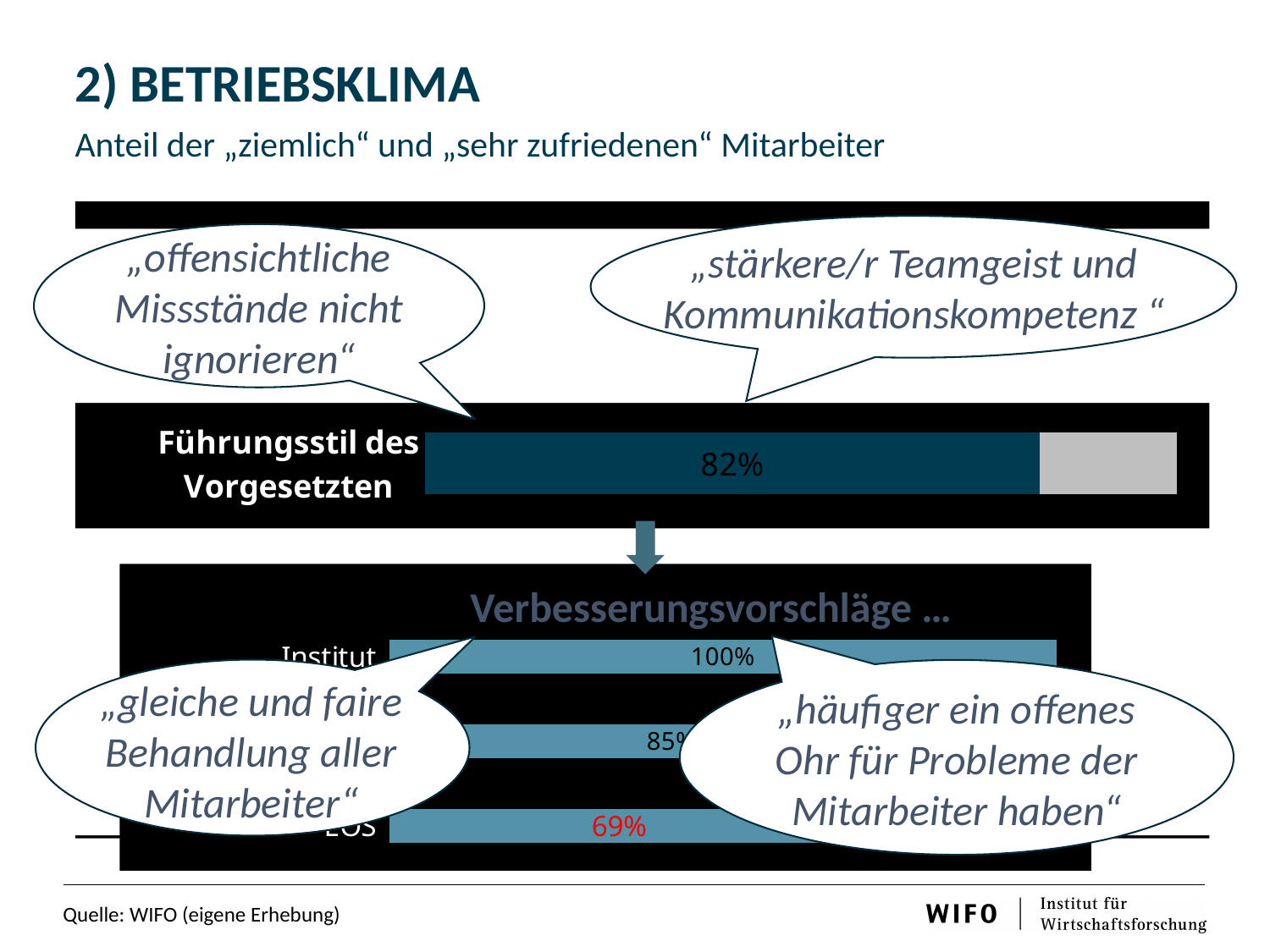
What is the title of the bottom chart on the slide? Verbesserungsvorschläge … In the top chart, what share of employees is shown for "Führungsstil des Vorgesetzten"? 82% In the top chart, is the value for "Führungsstil des Vorgesetzten" greater or less than 50%? greater In the bottom chart "Verbesserungsvorschläge …", which category has the highest value? Institut In the bottom chart "Verbesserungsvorschläge …", what value is shown for Institut? 100% What kind of chart is the bottom chart "Verbesserungsvorschläge …"? Bar chart In the bottom chart "Verbesserungsvorschläge …", which data label is printed in red? 69% In the bottom chart "Verbesserungsvorschläge …", which category has the lowest value? EOS How many bars are plotted in the bottom chart "Verbesserungsvorschläge …"? 3